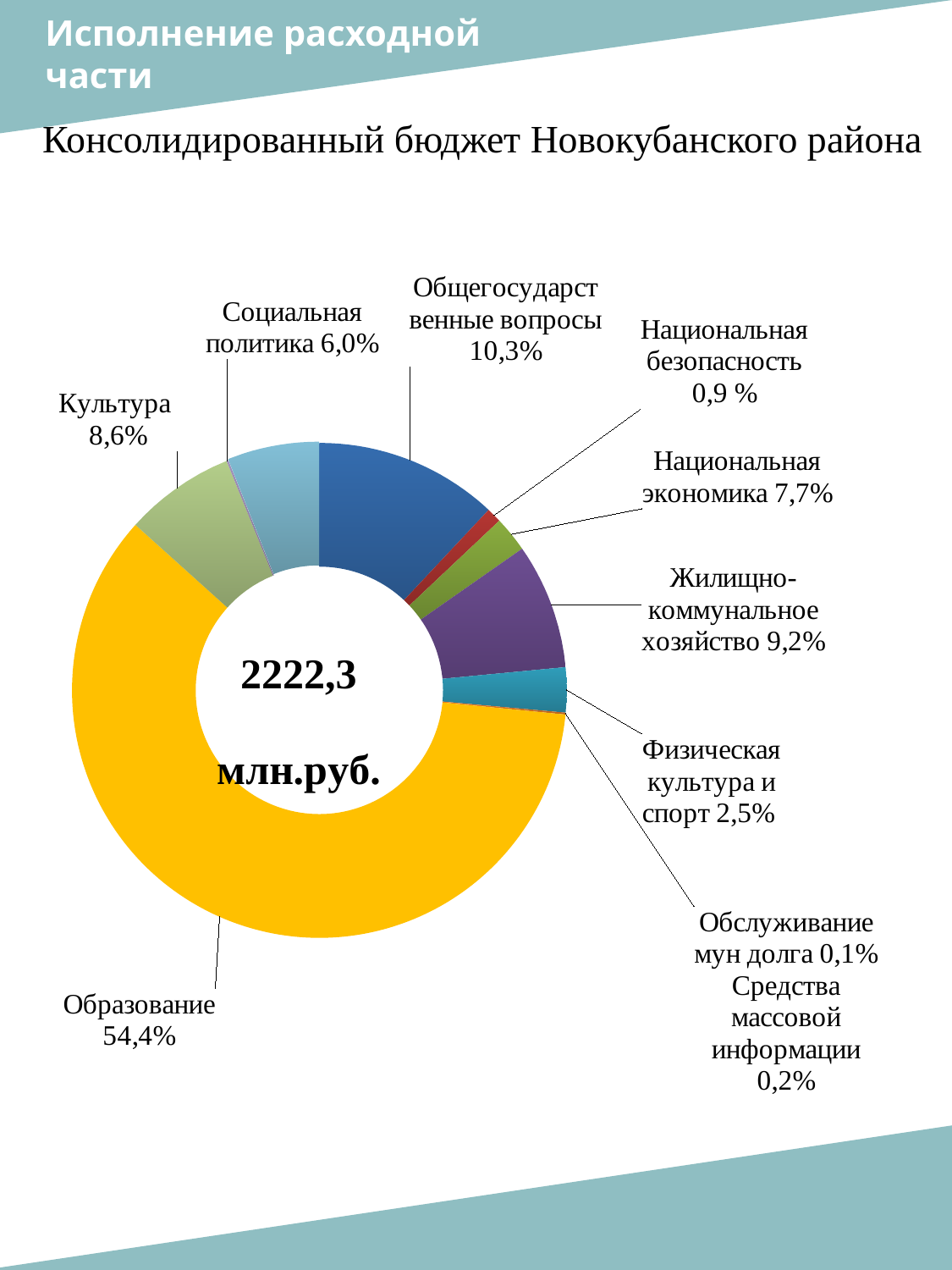
How many categories are shown in the chart? 10 Which category has the largest share of the chart? Образование What share is shown for Жилищно-коммунальное хозяйство? 9,2% Which category has the smallest share of the chart? Обслуживание мун долга What kind of chart is shown on the slide? Pie chart (doughnut) What share of the budget goes to Образование? 54,4% What share is shown for Социальная политика? 6,0% What share is shown for Физическая культура и спорт? 2,5% What is the difference in percentage points between Образование and Общегосударственные вопросы? 44,1 What share is shown for Общегосударственные вопросы? 10,3% What total value is printed in the centre of the chart? 2222,3 млн.руб. Which has the larger share, Культура or Национальная экономика? Культура